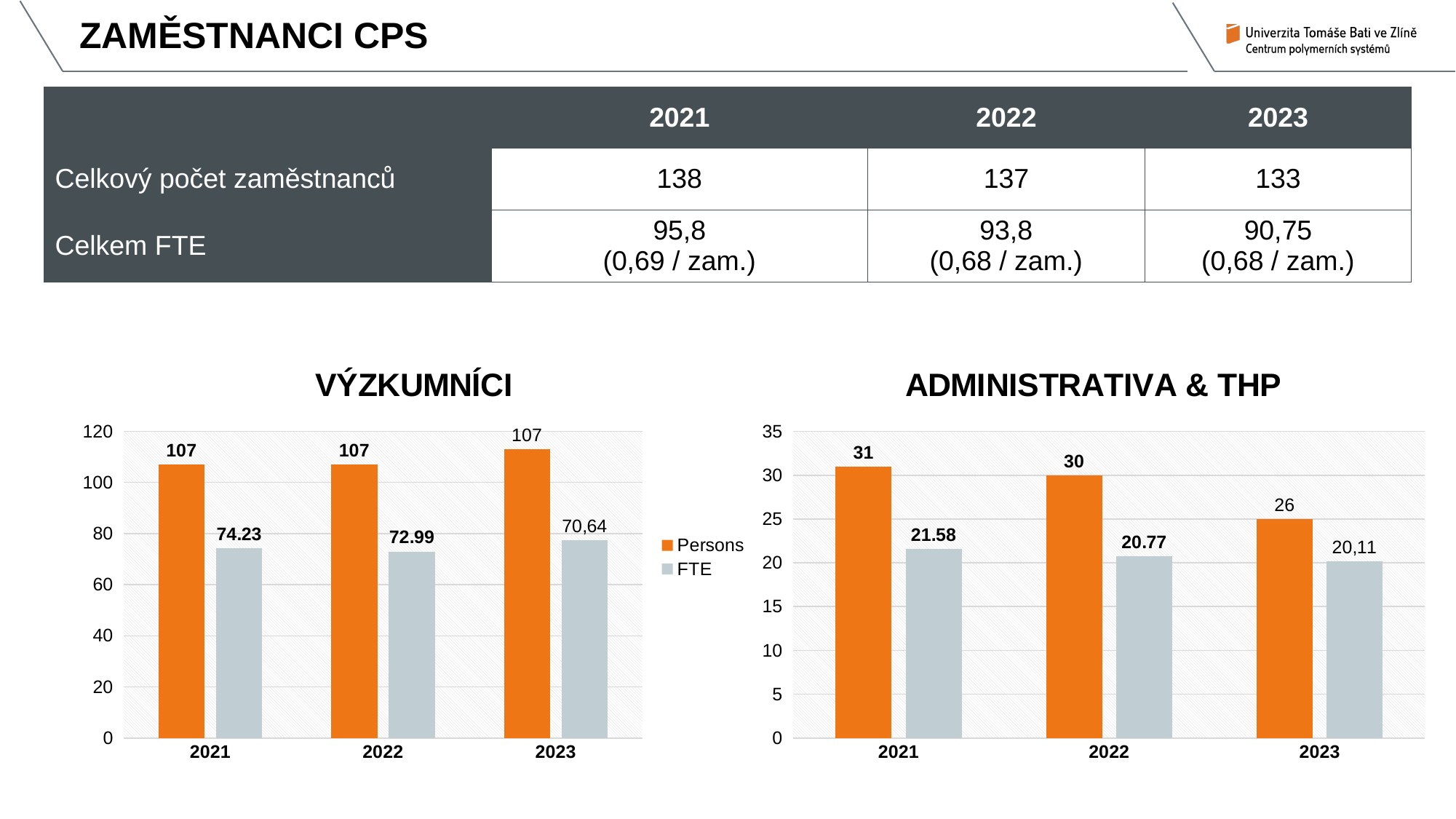
In the VÝZKUMNÍCI chart, what is the difference between the FTE values for 2021 and 2022? 1.24 In the ADMINISTRATIVA & THP chart, do the Persons values rise or fall from 2021 to 2023? fall What kind of chart is the ADMINISTRATIVA & THP chart? bar chart In the VÝZKUMNÍCI chart, is the FTE value for 2022 greater or less than 80? less In the ADMINISTRATIVA & THP chart, which year has the lowest Persons value? 2023 In the VÝZKUMNÍCI chart, what is the FTE value for 2021? 74.23 In the VÝZKUMNÍCI chart, what is the FTE value for 2022? 72.99 In the ADMINISTRATIVA & THP chart, what is the Persons value for 2022? 30 In the VÝZKUMNÍCI chart, what is the Persons value for 2021? 107 How many series does the legend of the VÝZKUMNÍCI chart list? 2 In the ADMINISTRATIVA & THP chart, what is the FTE value for 2021? 21.58 In the ADMINISTRATIVA & THP chart, what is the difference between the Persons values for 2021 and 2023? 5